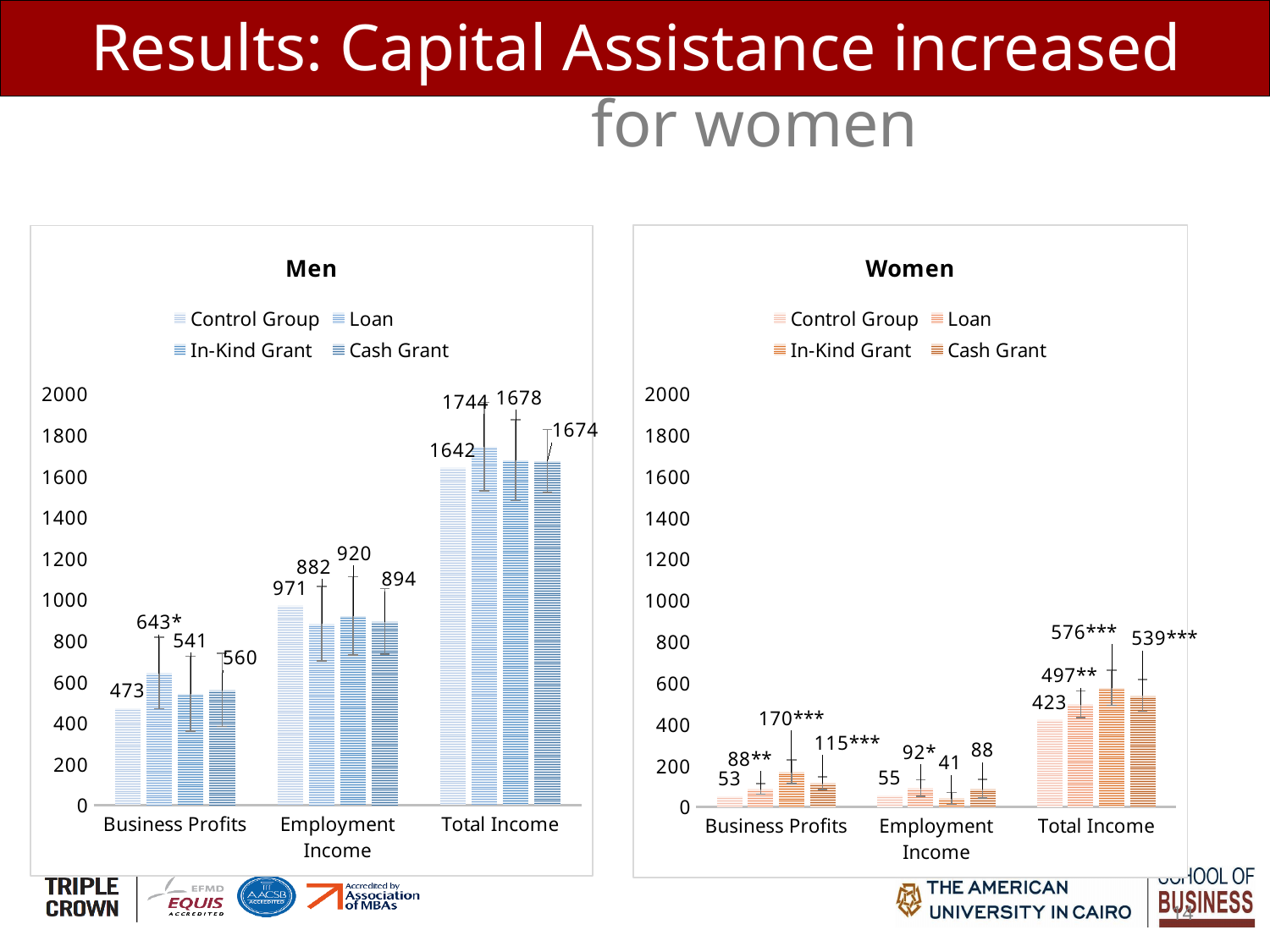
How many series does the legend of the Women chart list? 4 In the Women chart, which series has the lowest value for Employment Income? In-Kind Grant In the Men chart, which series has the highest value for Employment Income? Control Group In the Men chart, what is the difference between the Loan and Control Group values for Total Income? 102 In the Men chart, what is the Control Group value for Business Profits? 473 In the Men chart, is the Control Group value for Employment Income greater or less than 800? greater How many categories are shown on the x axis of the Men chart? 3 What type of chart is the Women chart? bar chart In the Men chart, what is the Loan value for Total Income? 1744 In the Women chart, what is the Cash Grant value for Total Income? 539*** In the Women chart, what is the In-Kind Grant value for Business Profits? 170*** In the Women chart, which is larger for Total Income: the In-Kind Grant value or the Loan value? In-Kind Grant